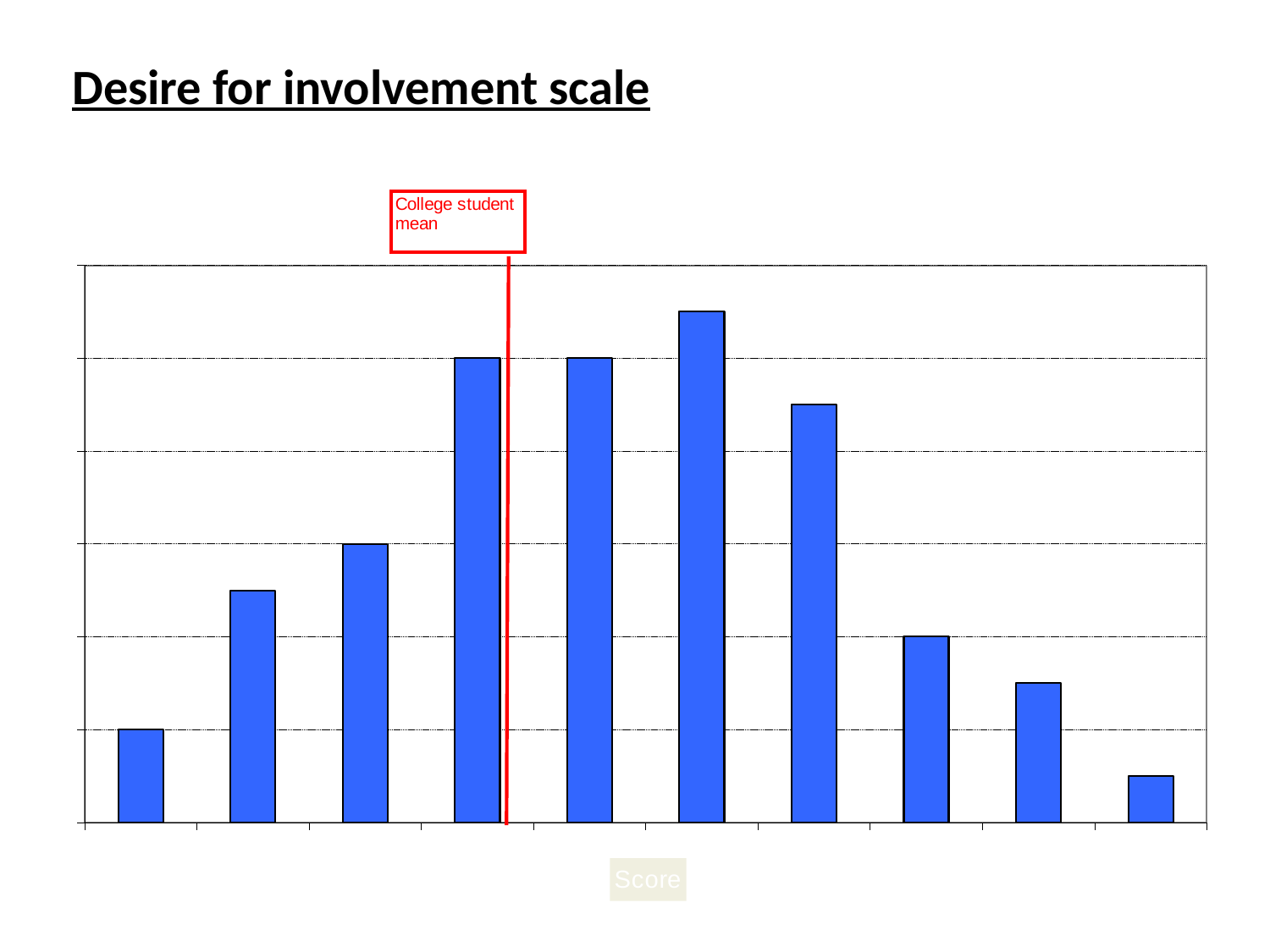
How many bars are plotted in the chart? 10 Which is taller, the second bar from the left or the third bar from the left? the third bar Counting from the left, which bar is the tallest in the chart? the sixth bar What kind of chart is shown on the slide? bar chart What label is given to the horizontal axis of the chart? Score What is the title of the chart on the slide? Desire for involvement scale Do the bar heights rise or fall moving from the first bar to the fourth bar along the x axis? rise Which is taller, the eighth bar from the left or the ninth bar from the left? the eighth bar Do the bar heights rise or fall moving from the sixth bar to the tenth bar along the x axis? fall Counting from the left, which bar is the shortest in the chart? the tenth (rightmost) bar Which is taller, the first bar from the left or the last bar on the right? the first bar